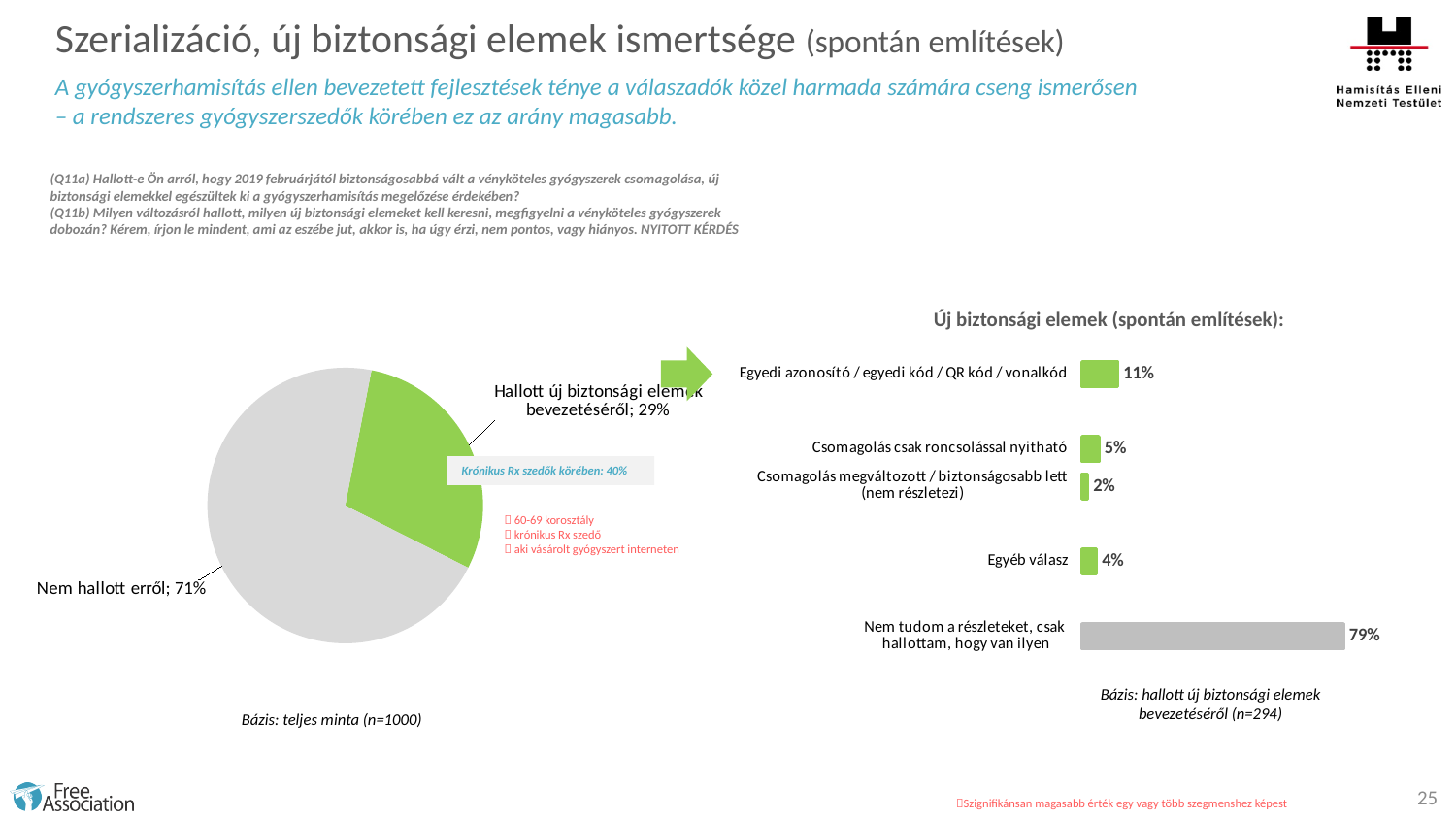
In the chart titled "Új biztonsági elemek (spontán említések):", which category has the highest value? Nem tudom a részleteket, csak hallottam, hogy van ilyen What kind of chart is the chart titled "Új biztonsági elemek (spontán említések):"? Bar chart In the chart titled "Új biztonsági elemek (spontán említések):", what is the value for "Egyedi azonosító / egyedi kód / QR kód / vonalkód"? 11% In the chart titled "Új biztonsági elemek (spontán említések):", which category has the lowest value? Csomagolás megváltozott / biztonságosabb lett (nem részletezi) In the chart titled "Új biztonsági elemek (spontán említések):", what is the value for "Nem tudom a részleteket, csak hallottam, hogy van ilyen"? 79% In the pie chart on the left, what share is labelled "Hallott új biztonsági elemek bevezetéséről"? 29% In the pie chart on the left, what is the difference between the "Nem hallott erről" and "Hallott új biztonsági elemek bevezetéséről" slices? 42 percentage points In the pie chart on the left, which slice is larger: "Nem hallott erről" or "Hallott új biztonsági elemek bevezetéséről"? Nem hallott erről How many slices does the pie chart on the left have? 2 In the chart titled "Új biztonsági elemek (spontán említések):", what is the difference between "Csomagolás csak roncsolással nyitható" and "Egyéb válasz"? 1 percentage point What kind of chart is the chart on the left of the slide? Pie chart In the pie chart on the left, what share of respondents is labelled "Nem hallott erről"? 71%